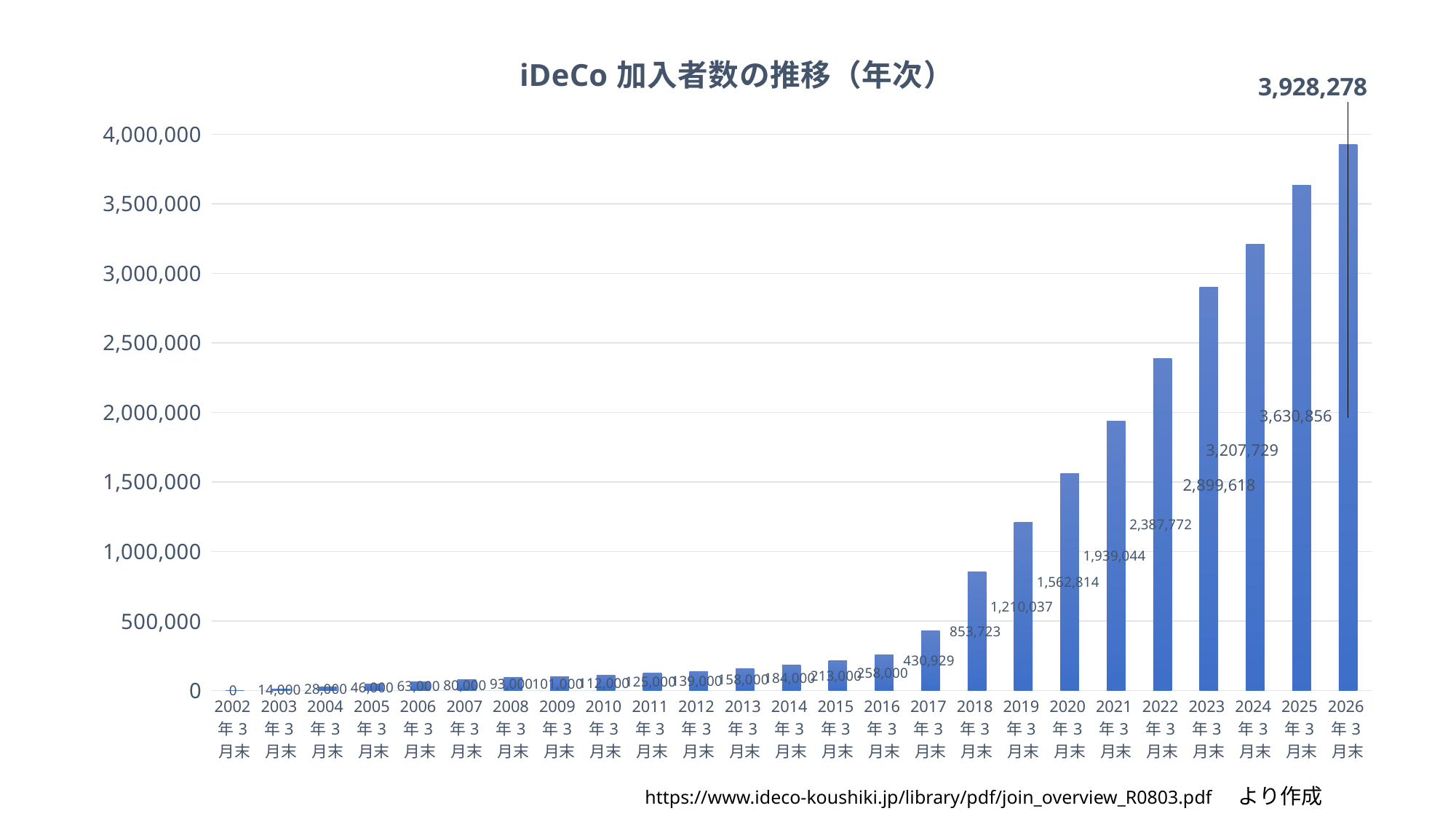
What is the difference between the values for 2026年3月末 and 2025年3月末? 297,422 What kind of chart is this? bar chart What is the value for 2023年3月末? 2,899,618 What is the difference between the values for 2019年3月末 and 2018年3月末? 356,314 What is the value for 2020年3月末? 1,562,814 Which category has the highest value? 2026年3月末 Is the value for 2024年3月末 greater or less than 3,000,000? greater What is the value for 2026年3月末? 3,928,278 Which is larger, the value for 2021年3月末 or the value for 2022年3月末? 2022年3月末 What is the value for 2017年3月末? 430,929 Which category has the lowest value? 2002年3月末 How many categories are shown on the x axis? 25